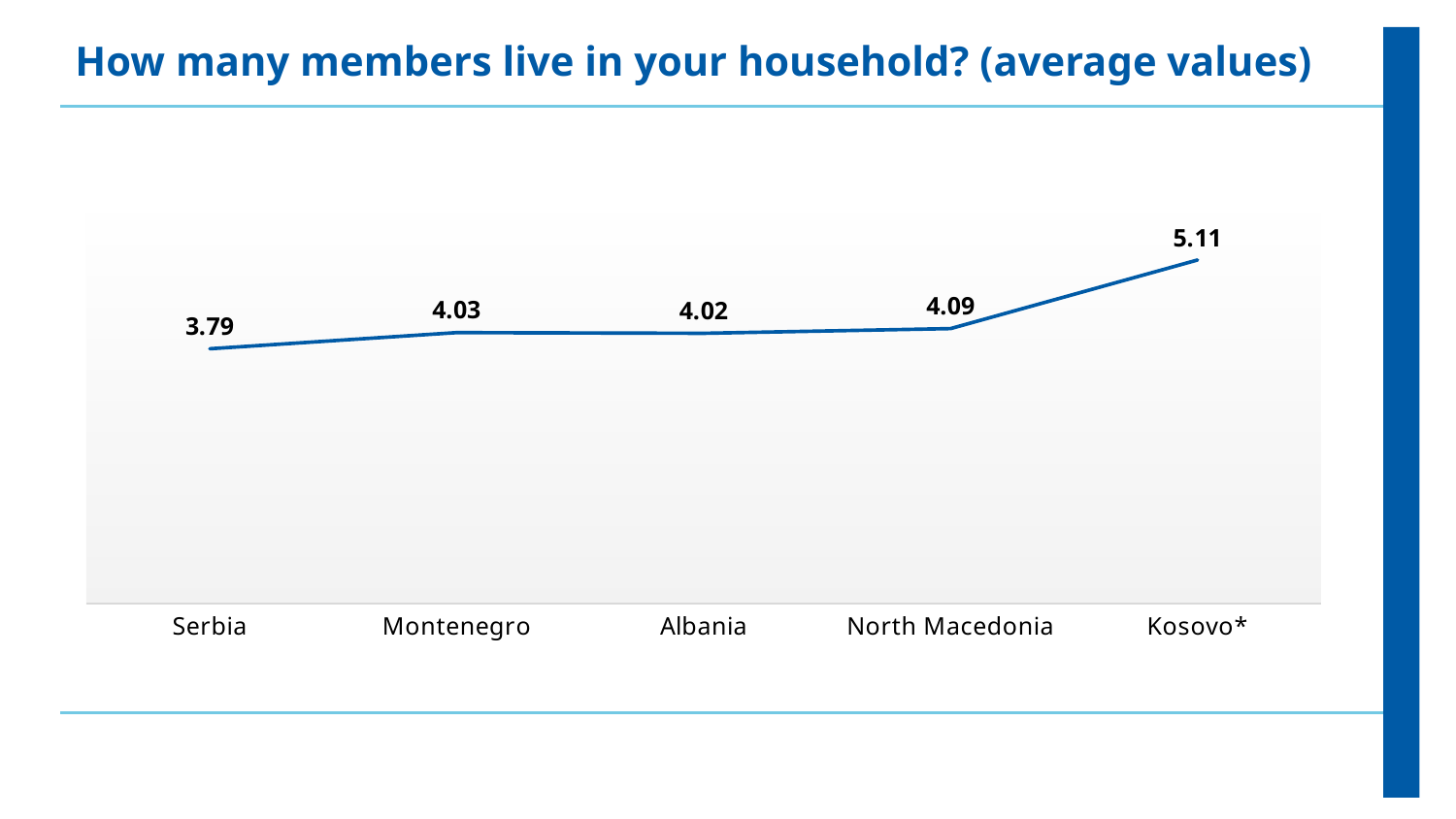
What is the average household size for North Macedonia? 4.09 Which has a larger average household size, Serbia or North Macedonia? North Macedonia What is the average household size for Montenegro? 4.03 What is the title of the chart? How many members live in your household? (average values) What is the average household size for Kosovo*? 5.11 What is the difference between the average household size in North Macedonia and Albania? 0.07 How many countries are shown on the chart? 5 What is the difference between the average household size in Kosovo* and Serbia? 1.32 Which country has the lowest average household size? Serbia Which country has the highest average household size? Kosovo* What is the average household size for Serbia? 3.79 What kind of chart is shown on the slide? Line chart